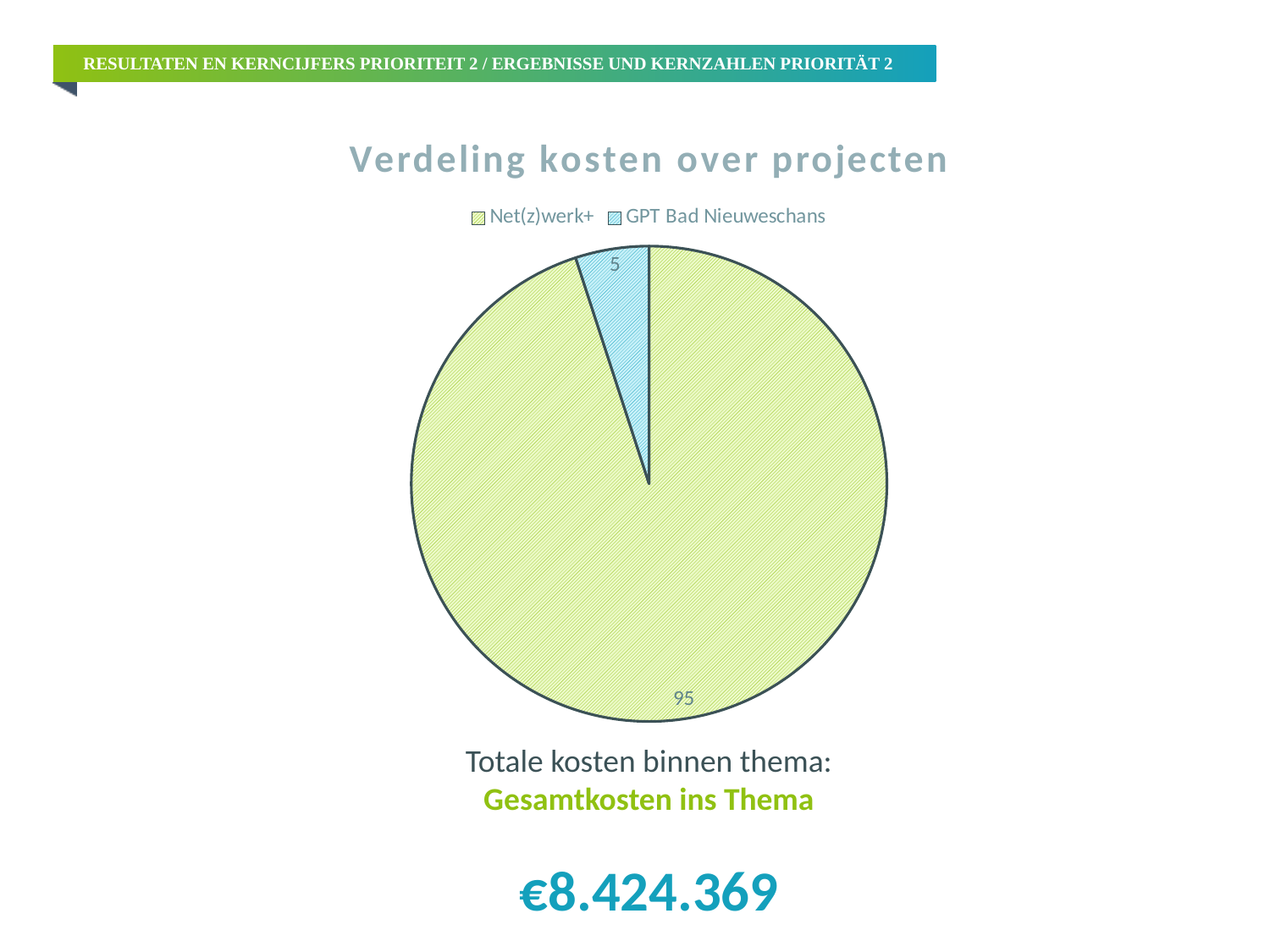
What is the total of the two values shown in the pie chart? 100 How many slices does the pie chart have? 2 What is the value shown for Net(z)werk+ in the pie chart? 95 How many entries does the legend list? 2 What kind of chart is shown on the slide? Pie chart Which slice of the pie chart is the largest? Net(z)werk+ What is the value shown for GPT Bad Nieuweschans in the pie chart? 5 What is the difference between the values for Net(z)werk+ and GPT Bad Nieuweschans? 90 What total cost amount is printed below the chart? €8.424.369 Which slice of the pie chart is the smallest? GPT Bad Nieuweschans Which is larger, the value for Net(z)werk+ or for GPT Bad Nieuweschans? Net(z)werk+ What is the title of the chart? Verdeling kosten over projecten